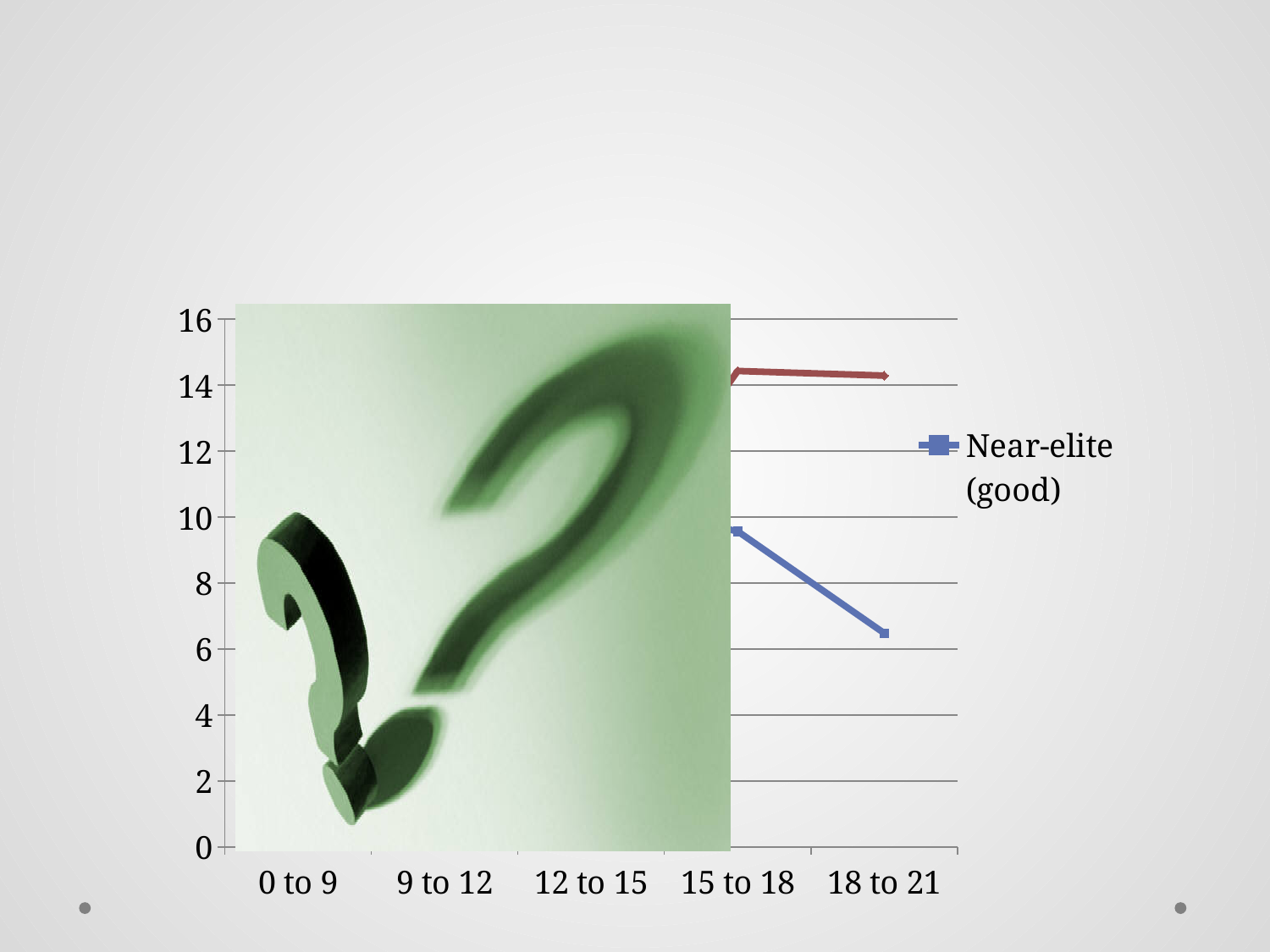
For Near-elite (good), which is larger: the value at 15 to 18 or the value at 18 to 21? 15 to 18 Does the Near-elite (good) line rise or fall from 15 to 18 to 18 to 21? fall What kind of chart is shown on the slide? line chart Is the value for Near-elite (good) at 18 to 21 greater or less than 8? less How many categories are shown on the x axis? 5 Is the value for Near-elite (good) at 15 to 18 greater or less than 12? less What is the label of the last category on the x axis? 18 to 21 What is the highest value shown on the y axis? 16 Is the value for Near-elite (good) at 15 to 18 greater or less than 8? greater